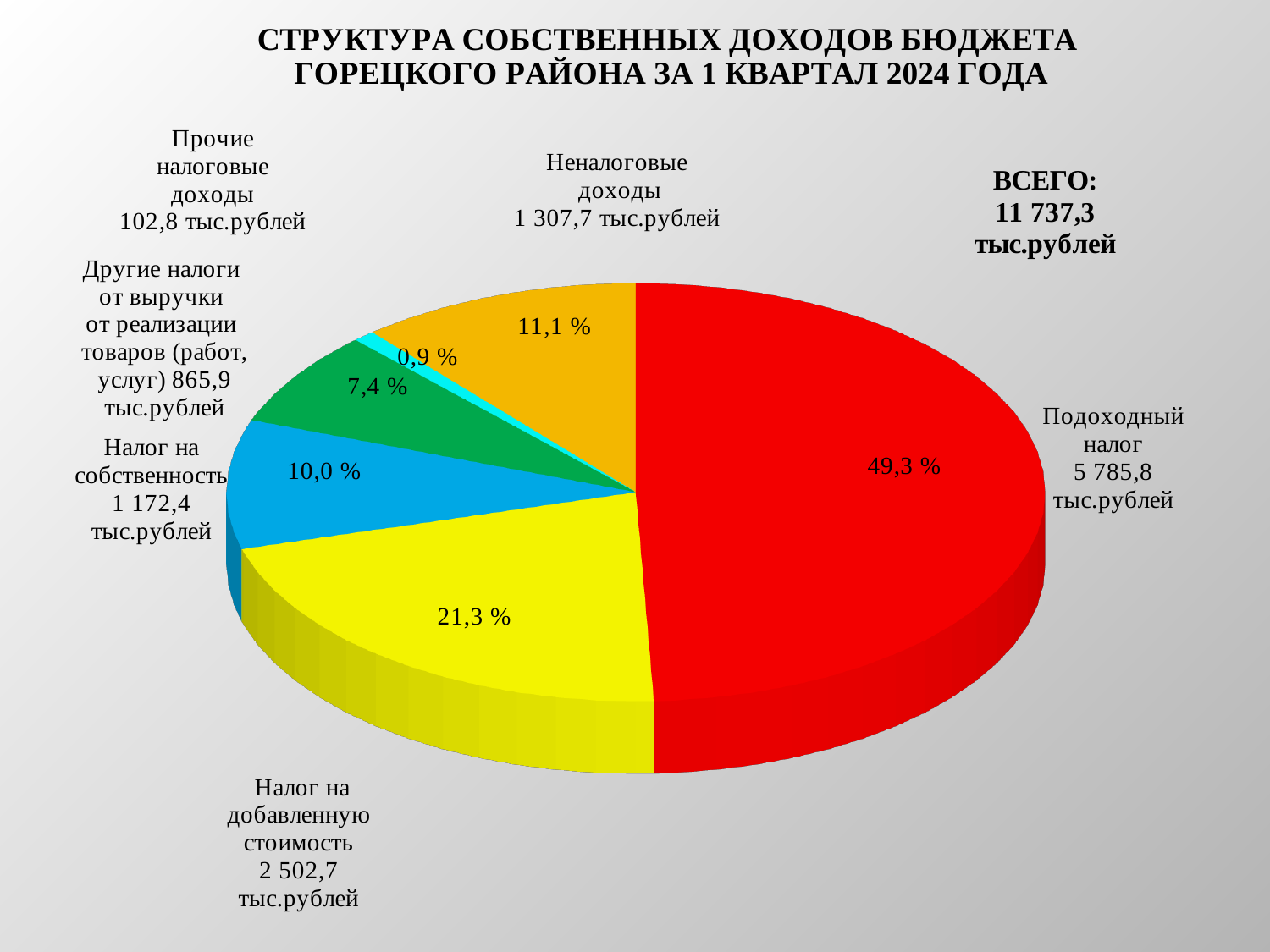
Which category has the largest slice of the pie? Подоходный налог What share of the pie does Налог на добавленную стоимость have? 21,3 % What colour is the slice for Подоходный налог? red Which category has the smallest slice of the pie? Прочие налоговые доходы Which is larger: Неналоговые доходы or Налог на собственность? Неналоговые доходы What is the difference between the values for Подоходный налог and Налог на добавленную стоимость? 3 283,1 тыс.рублей What total (ВСЕГО) is shown on the slide? 11 737,3 тыс.рублей How many slices does the pie chart have? 6 What kind of chart is shown on the slide? pie chart What is the value shown for Неналоговые доходы? 1 307,7 тыс.рублей What is the value shown for Налог на собственность? 1 172,4 тыс.рублей What share of the pie does Подоходный налог have? 49,3 %